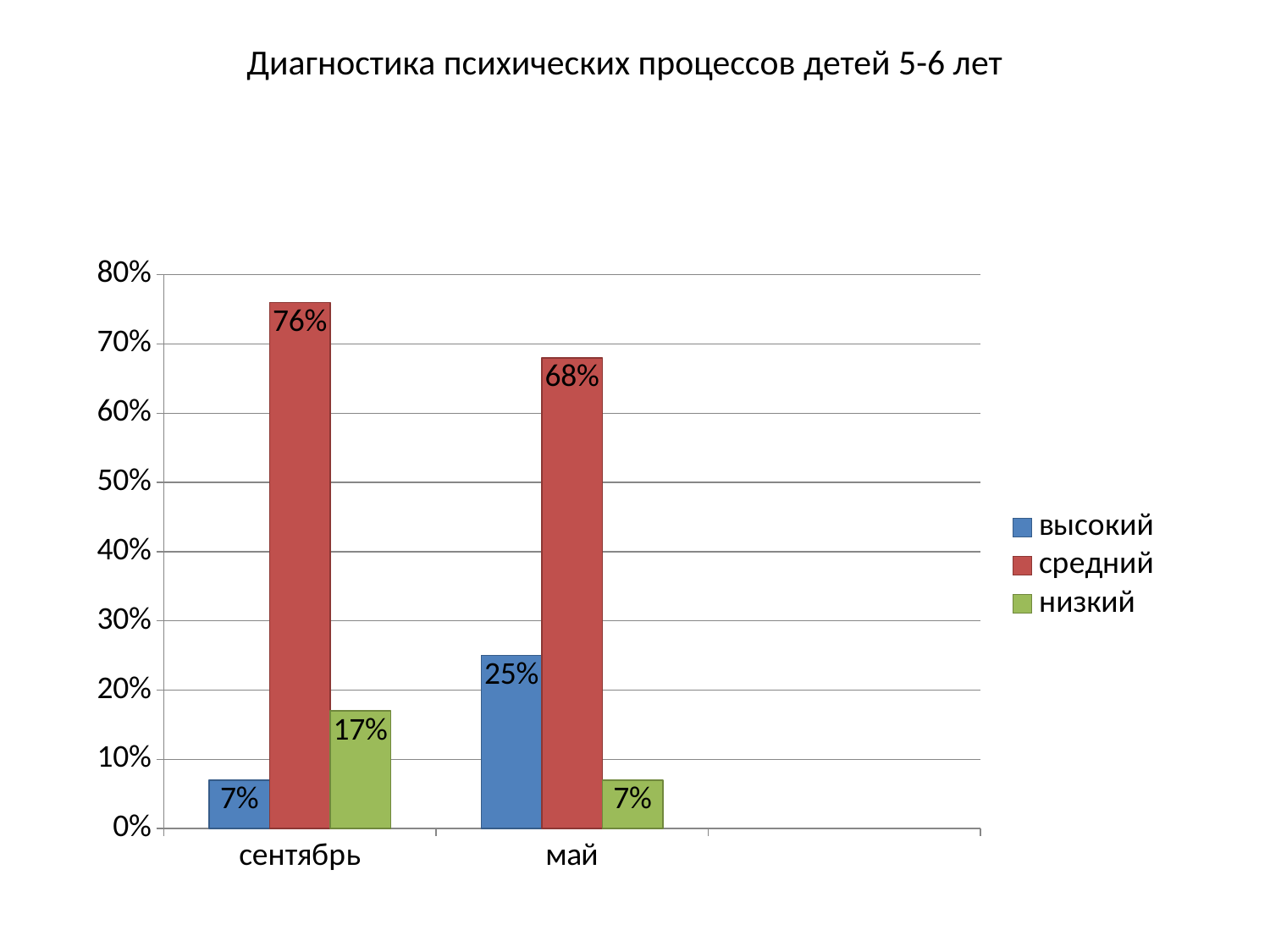
What is the value for низкий in сентябрь? 17% What is the difference between the средний values in сентябрь and май? 8% How many categories are shown on the x axis? 2 What is the title of the chart? Диагностика психических процессов детей 5-6 лет What is the value for высокий in май? 25% What is the value for средний in май? 68% How many series does the legend list? 3 Which is larger: высокий in май or низкий in сентябрь? высокий in май What kind of chart is this? bar chart What is the value for высокий in сентябрь? 7% Which series has the highest value in сентябрь? средний Which series has the lowest value in май? низкий